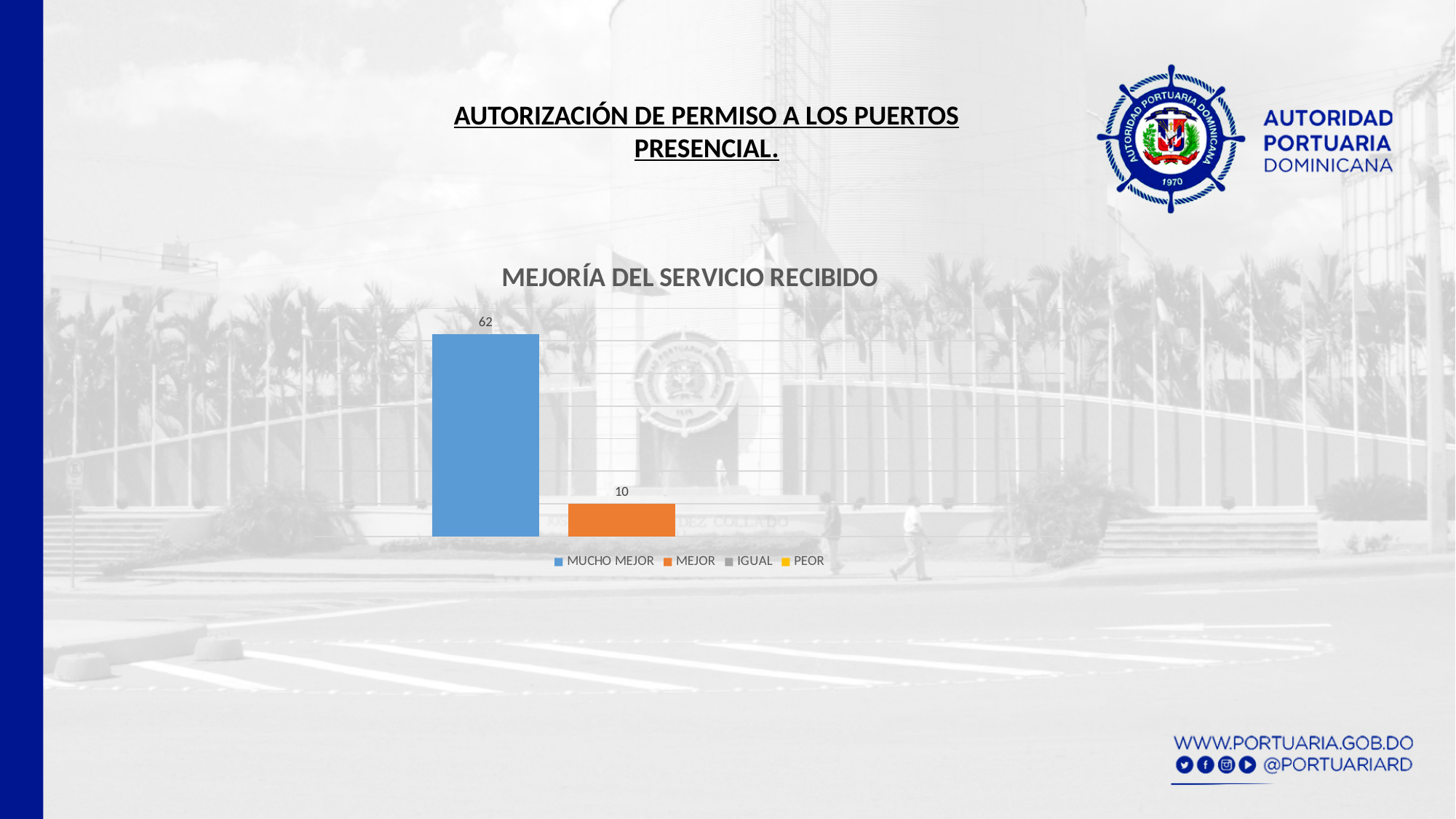
What is the value for MUCHO MEJOR in the MEJORÍA DEL SERVICIO RECIBIDO chart? 62 What is the difference between the MUCHO MEJOR and MEJOR values in the MEJORÍA DEL SERVICIO RECIBIDO chart? 52 Which series has the highest value in the MEJORÍA DEL SERVICIO RECIBIDO chart? MUCHO MEJOR What is the total of the MUCHO MEJOR and MEJOR values in the MEJORÍA DEL SERVICIO RECIBIDO chart? 72 What kind of chart is MEJORÍA DEL SERVICIO RECIBIDO? Bar chart Which is larger in the MEJORÍA DEL SERVICIO RECIBIDO chart, MUCHO MEJOR or MEJOR? MUCHO MEJOR What is the title of the chart on the slide? MEJORÍA DEL SERVICIO RECIBIDO How many bars are visibly plotted in the MEJORÍA DEL SERVICIO RECIBIDO chart? 2 What colour is the MEJOR bar in the MEJORÍA DEL SERVICIO RECIBIDO chart? Orange How many series does the legend of the MEJORÍA DEL SERVICIO RECIBIDO chart list? 4 What is the value for MEJOR in the MEJORÍA DEL SERVICIO RECIBIDO chart? 10